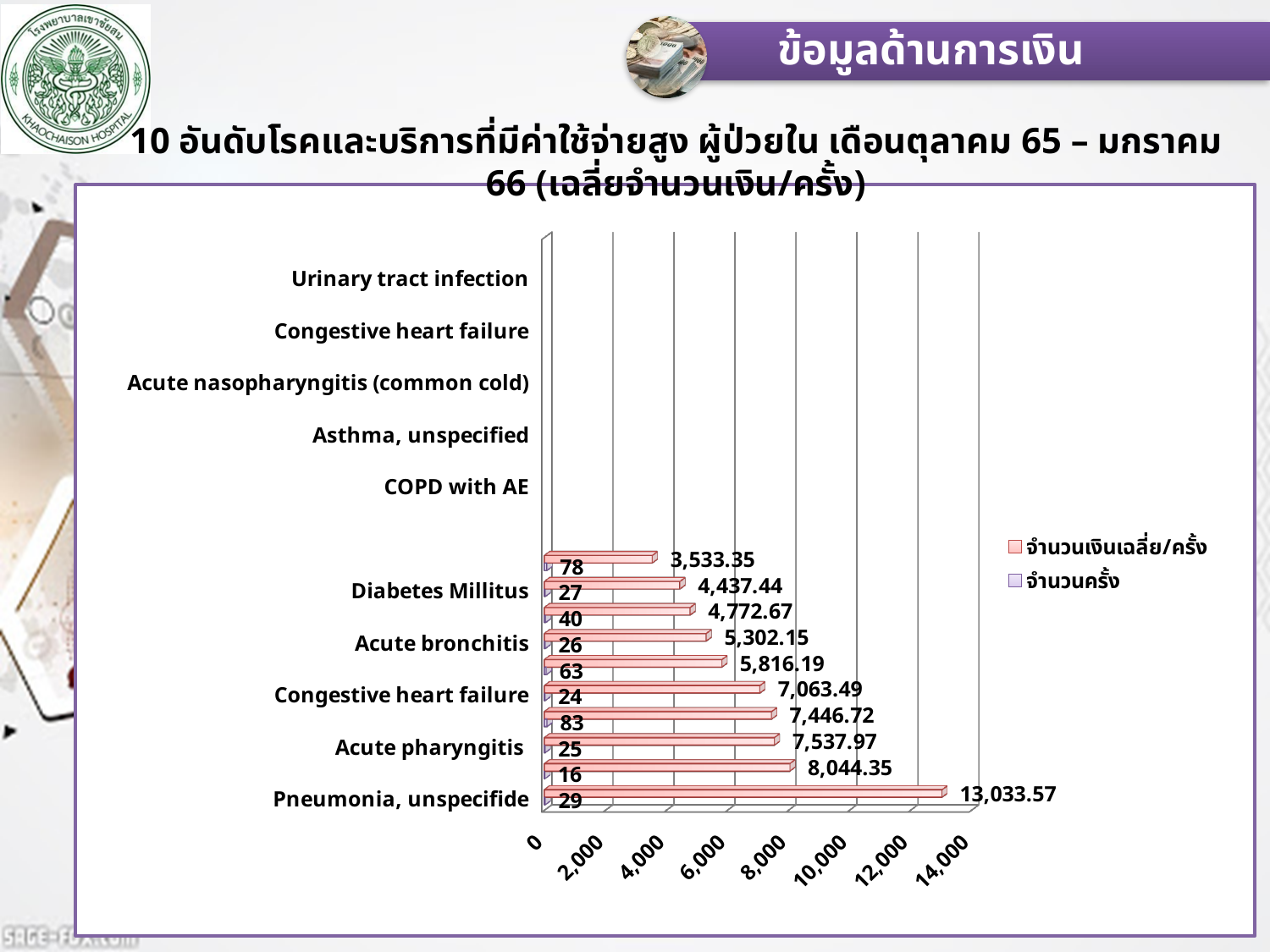
What is the จำนวนครั้ง value for Pneumonia, unspecifide? 29 What is the highest จำนวนเงินเฉลี่ย/ครั้ง value shown on the chart? 13,033.57 Which has a larger จำนวนเงินเฉลี่ย/ครั้ง value, Acute pharyngitis or Diabetes Millitus? Acute pharyngitis What is the จำนวนครั้ง value for Acute bronchitis? 26 How many series does the legend list? 2 Which category has the highest จำนวนเงินเฉลี่ย/ครั้ง value? Pneumonia, unspecifide What is the จำนวนเงินเฉลี่ย/ครั้ง value for Pneumonia, unspecifide? 13,033.57 What kind of chart is shown on the slide? bar chart What is the lowest จำนวนเงินเฉลี่ย/ครั้ง value labelled on the chart? 3,533.35 Is the จำนวนเงินเฉลี่ย/ครั้ง value for Pneumonia, unspecifide greater or less than 12,000? greater What is the จำนวนเงินเฉลี่ย/ครั้ง value for Acute pharyngitis? 7,537.97 What is the จำนวนเงินเฉลี่ย/ครั้ง value for Diabetes Millitus? 4,437.44